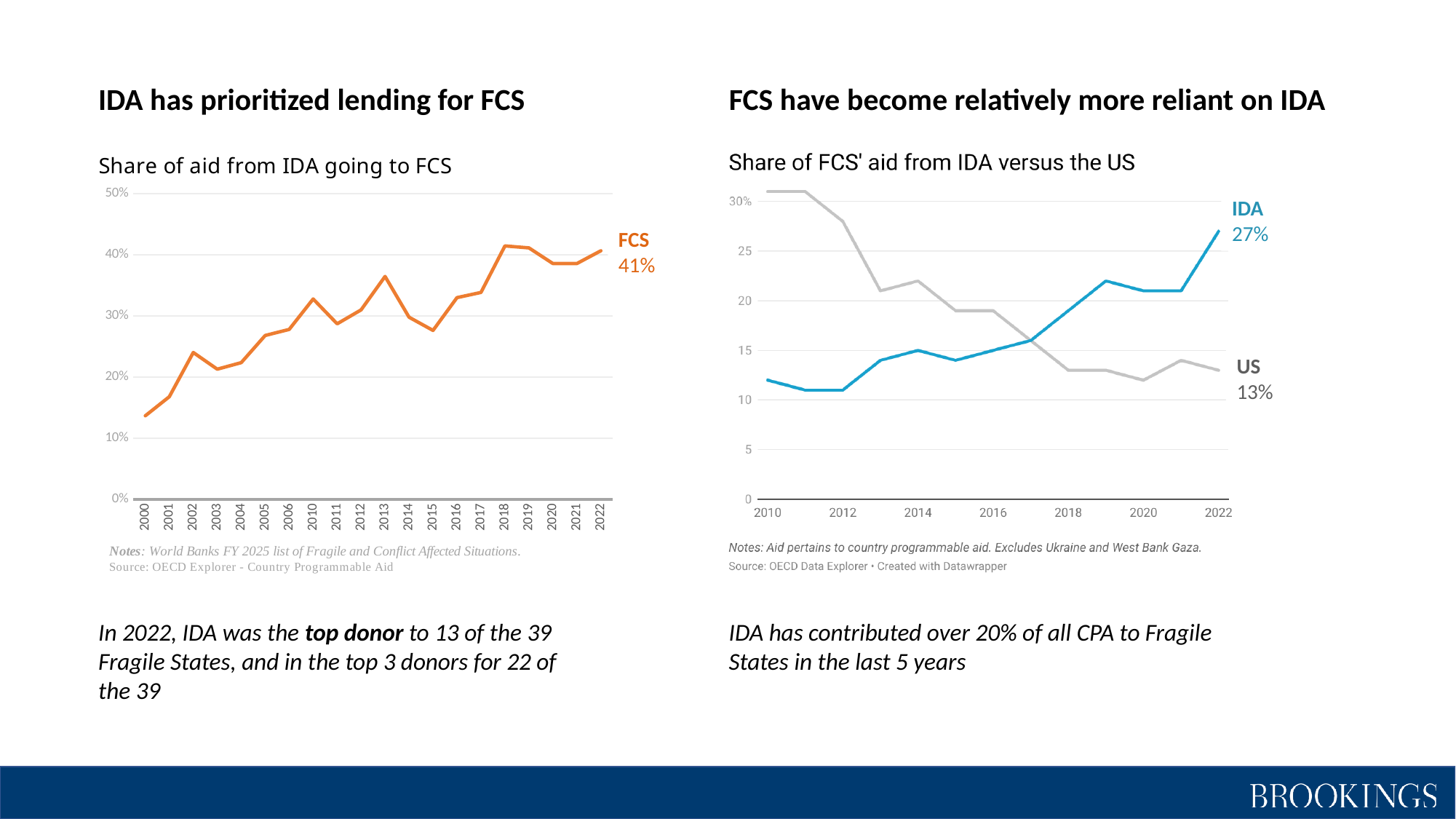
In the right chart, 'Share of FCS' aid from IDA versus the US', what is the IDA value shown for 2022? 27% In the right chart, 'Share of FCS' aid from IDA versus the US', which is larger in 2022, IDA or US? IDA What kind of chart is the left chart, 'Share of aid from IDA going to FCS'? line chart In the left chart, 'Share of aid from IDA going to FCS', is the value for 2013 greater or less than 30%? greater In the right chart, 'Share of FCS' aid from IDA versus the US', is the US value for 2010 greater or less than 25? greater In the right chart, 'Share of FCS' aid from IDA versus the US', does the US line rise or fall from 2010 to 2022? fall In the right chart, 'Share of FCS' aid from IDA versus the US', what is the difference between the IDA and US values in 2022? 14% In the left chart, 'Share of aid from IDA going to FCS', what is the FCS value shown for 2022? 41% In the left chart, 'Share of aid from IDA going to FCS', is the value for 2000 greater or less than 20%? less How many series are plotted in the right chart, 'Share of FCS' aid from IDA versus the US'? 2 In the left chart, 'Share of aid from IDA going to FCS', does the share generally rise or fall from 2000 to 2022? rise In the right chart, 'Share of FCS' aid from IDA versus the US', what is the US value shown for 2022? 13%